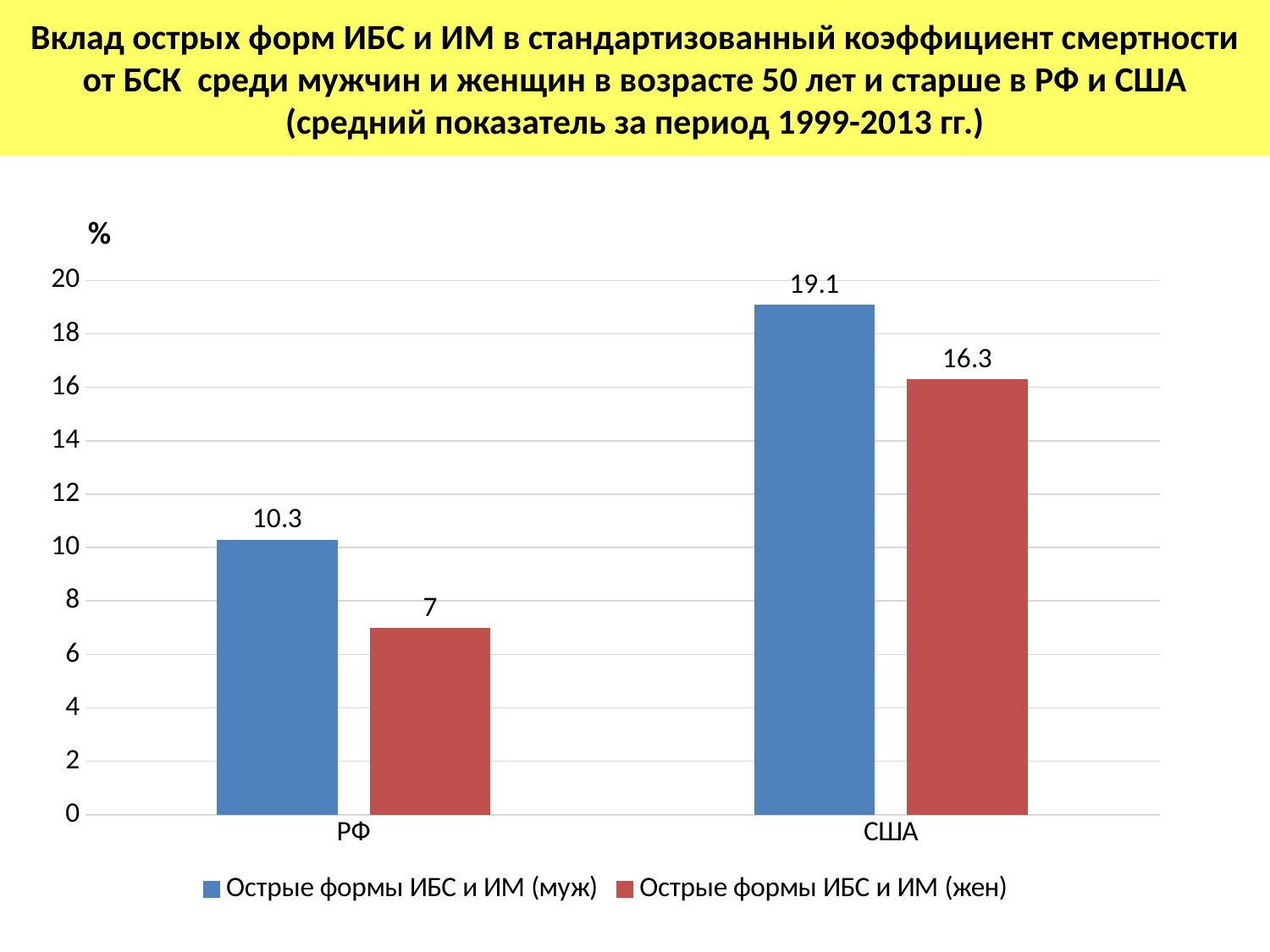
What is the value for women (Острые формы ИБС и ИМ (жен)) in РФ? 7 Which is larger: the women's value in США or the men's value in РФ? the women's value in США How many series does the legend list? 2 What is the difference between the men's and women's values in США? 2.8 Which bar has the lowest value on the chart? РФ, Острые формы ИБС и ИМ (жен) Which bar has the highest value on the chart? США, Острые формы ИБС и ИМ (муж) What is the value for men (Острые формы ИБС и ИМ (муж)) in США? 19.1 What is the difference between the men's values for США and РФ? 8.8 What kind of chart is shown on the slide? bar chart What is the value for women (Острые формы ИБС и ИМ (жен)) in США? 16.3 What is the value for men (Острые формы ИБС и ИМ (муж)) in РФ? 10.3 How many categories are shown on the x axis? 2